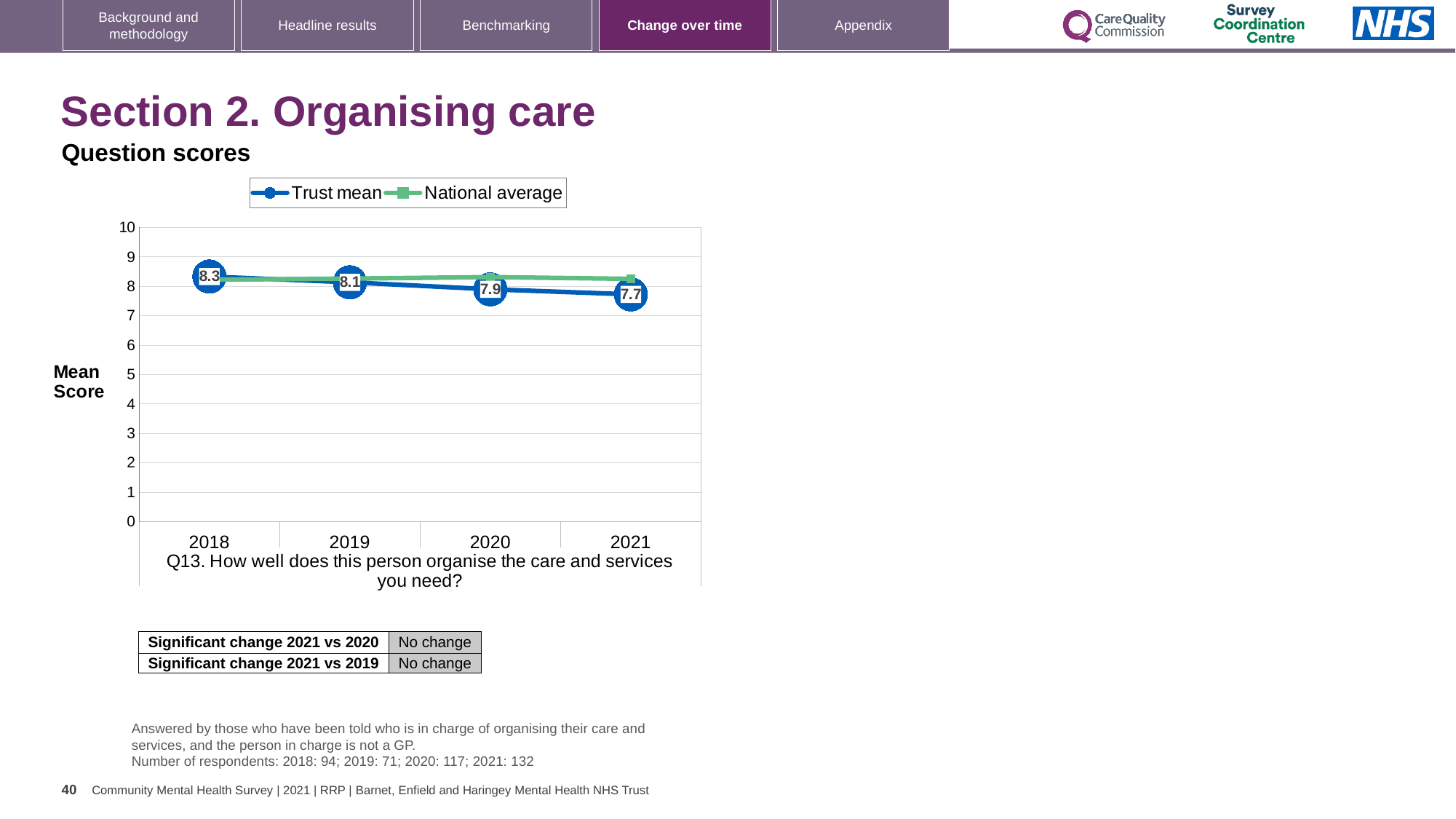
How many series does the legend list? 2 What is the difference between the Trust mean in 2018 and in 2021? 0.6 What kind of chart is shown? Line chart Is the Trust mean for 2021 greater or less than 8? less What is the Trust mean score for 2021? 7.7 In which year is the Trust mean lowest? 2021 In which year is the Trust mean highest? 2018 In 2021, which is higher: the Trust mean or the National average? National average What is the Trust mean score for 2018? 8.3 What is the Trust mean score for 2020? 7.9 Does the Trust mean rise or fall from 2018 to 2021? Fall How many years are plotted on the x axis? 4